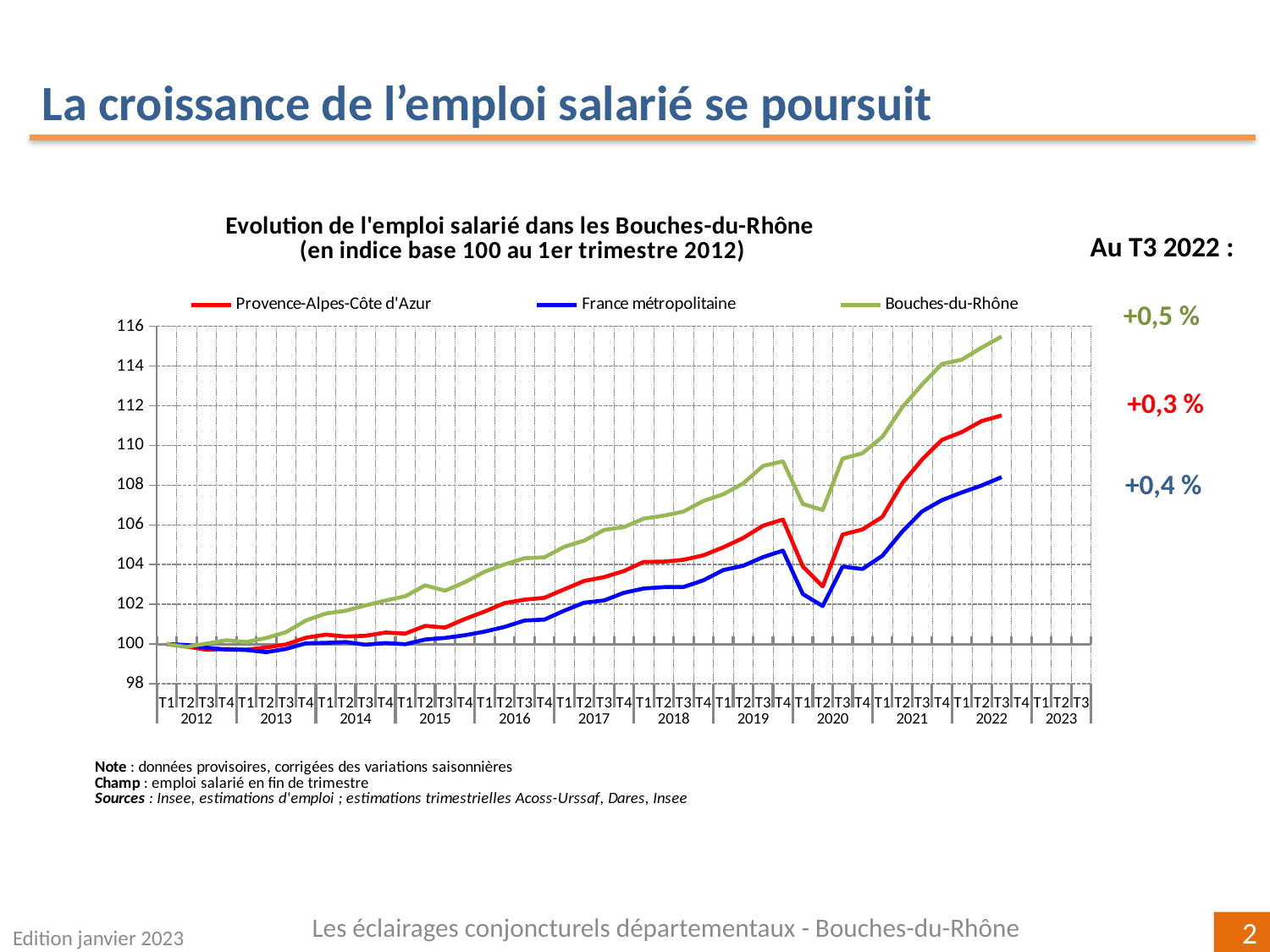
What kind of chart is shown on the slide? line chart Overall, do the values rise or fall from 2012 to 2022? rise Is the value for Provence-Alpes-Côte d'Azur at T3 2022 greater or less than 110? greater Which series has the lowest value at T3 2022? France métropolitaine How many years are labelled on the x axis? 12 Is the value for France métropolitaine at T3 2022 greater or less than 110? less Which series has the highest value at T3 2022? Bouches-du-Rhône At T3 2022, which is larger: the value for Bouches-du-Rhône or the value for France métropolitaine? Bouches-du-Rhône What colour is the line for Bouches-du-Rhône? green Is the value for Bouches-du-Rhône at T3 2022 greater or less than 114? greater How many series does the legend list? 3